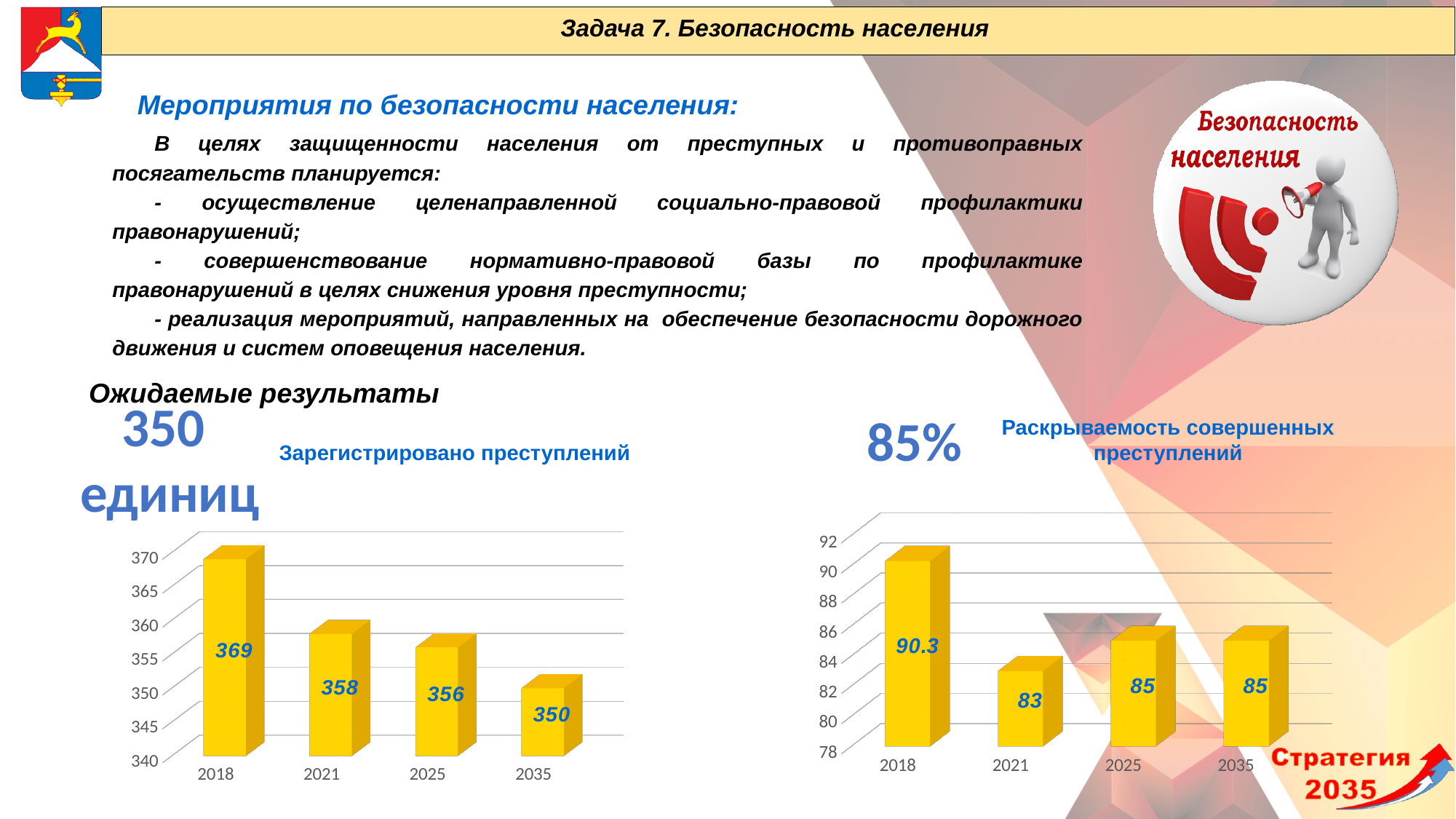
In the chart 'Зарегистрировано преступлений', what is the value for 2018? 369 In the chart 'Зарегистрировано преступлений', which year has the lowest value? 2035 In the chart 'Раскрываемость совершенных преступлений', which year has the highest value? 2018 In the chart 'Зарегистрировано преступлений', how many years are shown on the x axis? 4 In the chart 'Зарегистрировано преступлений', what is the difference between the values for 2018 and 2035? 19 In the chart 'Зарегистрировано преступлений', what is the value for 2035? 350 In the chart 'Раскрываемость совершенных преступлений', what is the difference between the values for 2018 and 2021? 7.3 What kind of chart is 'Зарегистрировано преступлений'? bar chart In the chart 'Раскрываемость совершенных преступлений', which is larger, the value for 2021 or the value for 2025? 2025 In the chart 'Раскрываемость совершенных преступлений', what is the value for 2018? 90.3 In the chart 'Раскрываемость совершенных преступлений', what is the value for 2021? 83 In the chart 'Зарегистрировано преступлений', do the values rise or fall from 2018 to 2035? fall